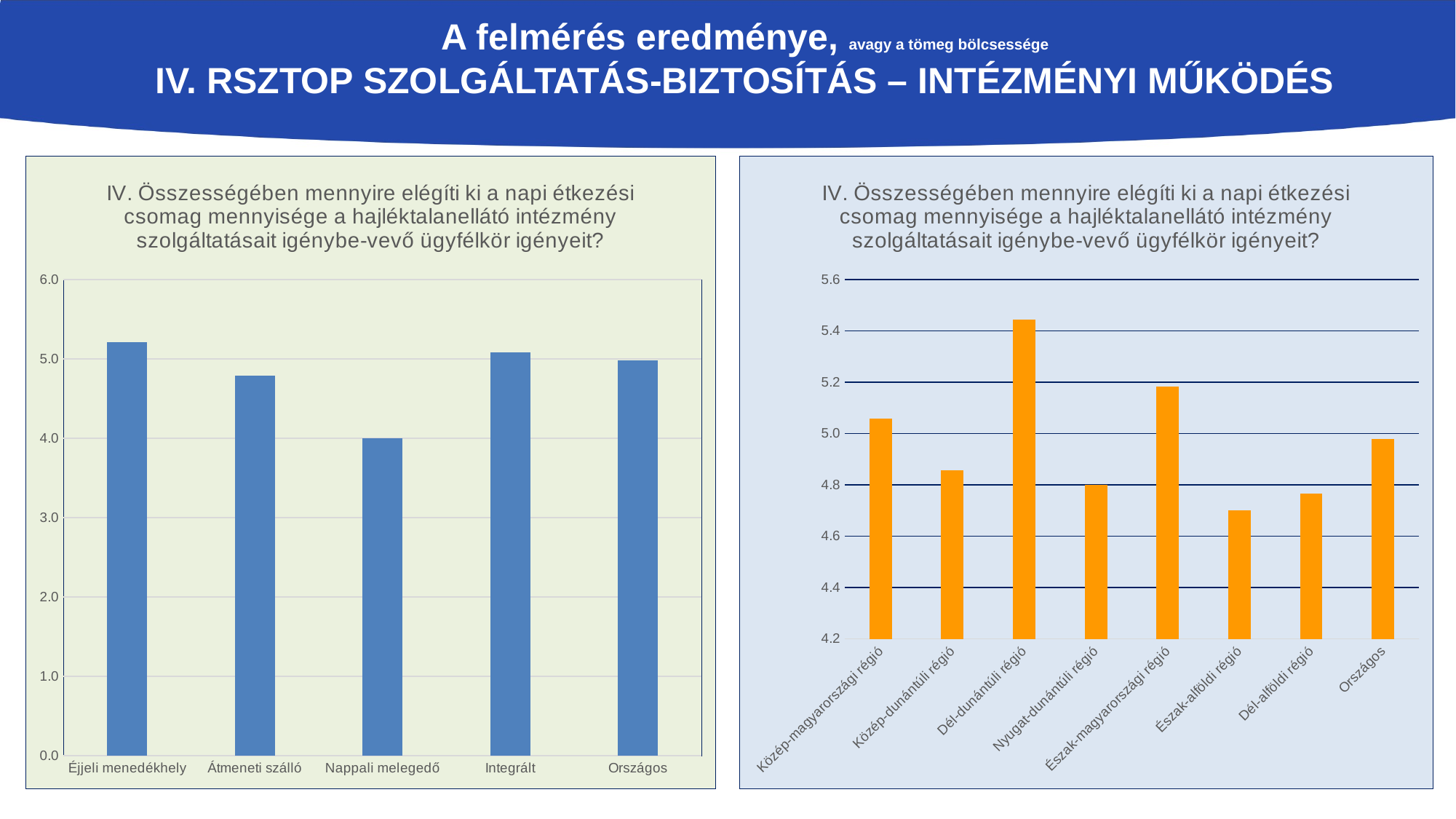
In the left chart, which category has the lowest value? Nappali melegedő In the right chart, which region has the lowest value? Észak-alföldi régió What kind of chart is the right chart on the slide? bar chart In the left chart, how many categories are shown on the x axis? 5 In the left chart, is the value for Átmeneti szálló greater or less than 5.0? less What colour are the bars in the right chart? orange In the right chart, is the value for Dél-dunántúli régió greater or less than 5.4? greater What kind of chart is the left chart on the slide? bar chart In the left chart, which category has the highest value? Éjjeli menedékhely In the right chart, how many categories are shown on the x axis? 8 In the right chart, which region has the highest value? Dél-dunántúli régió In the right chart, which is larger, the value for Észak-magyarországi régió or the value for Nyugat-dunántúli régió? Észak-magyarországi régió